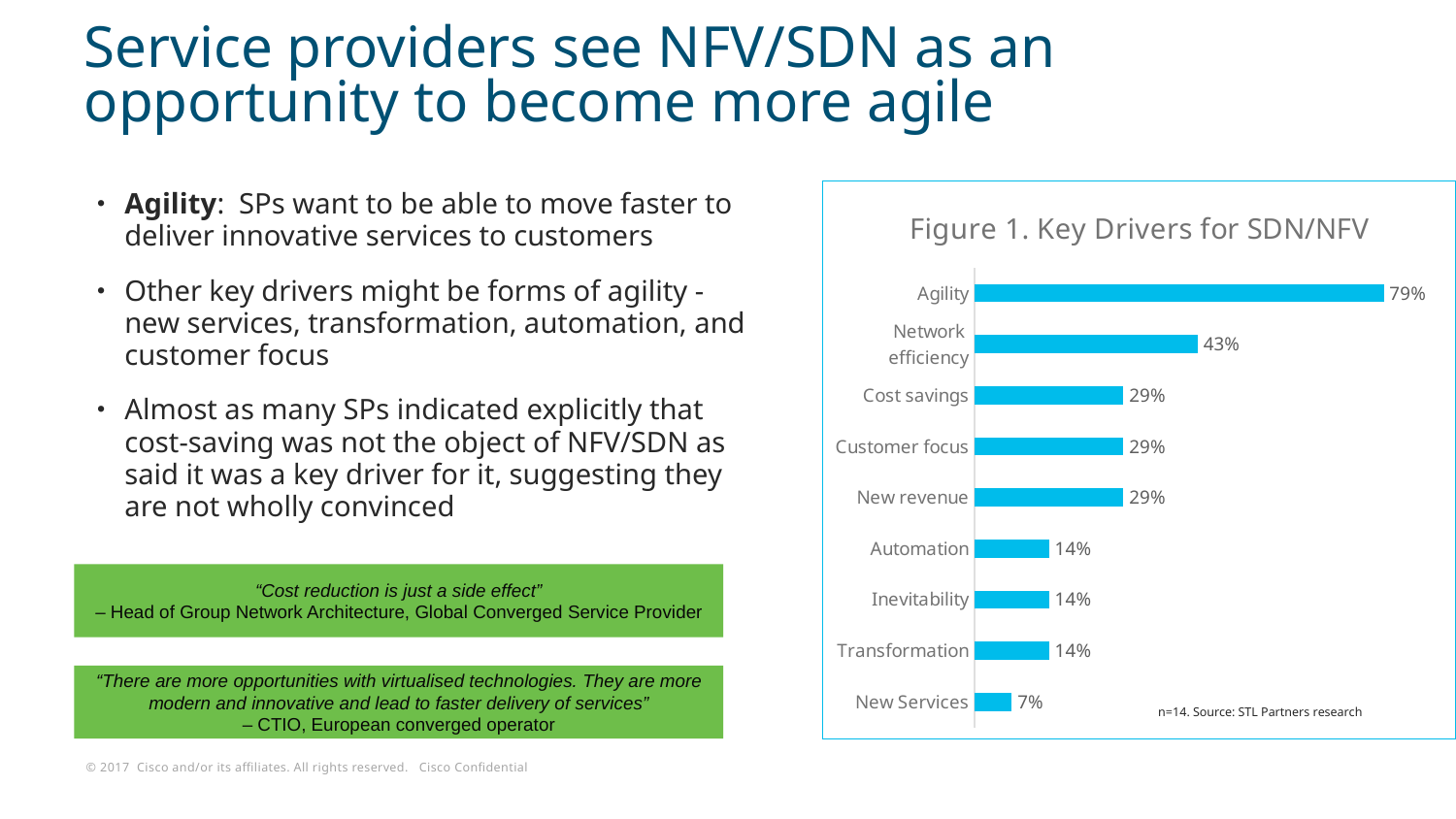
How many categories are shown in the chart? 9 What is the title of the chart? Figure 1. Key Drivers for SDN/NFV Which category has the highest value? Agility What is the value for New Services? 7% Which category has the lowest value? New Services Which is larger, the value for Network efficiency or the value for Customer focus? Network efficiency What is the value for Agility in the Key Drivers for SDN/NFV chart? 79% What is the value for Automation? 14% What is the difference between the values for Cost savings and Transformation? 15% What is the difference between the values for Agility and Network efficiency? 36% What kind of chart is shown on the slide? Bar chart What is the value for Network efficiency? 43%